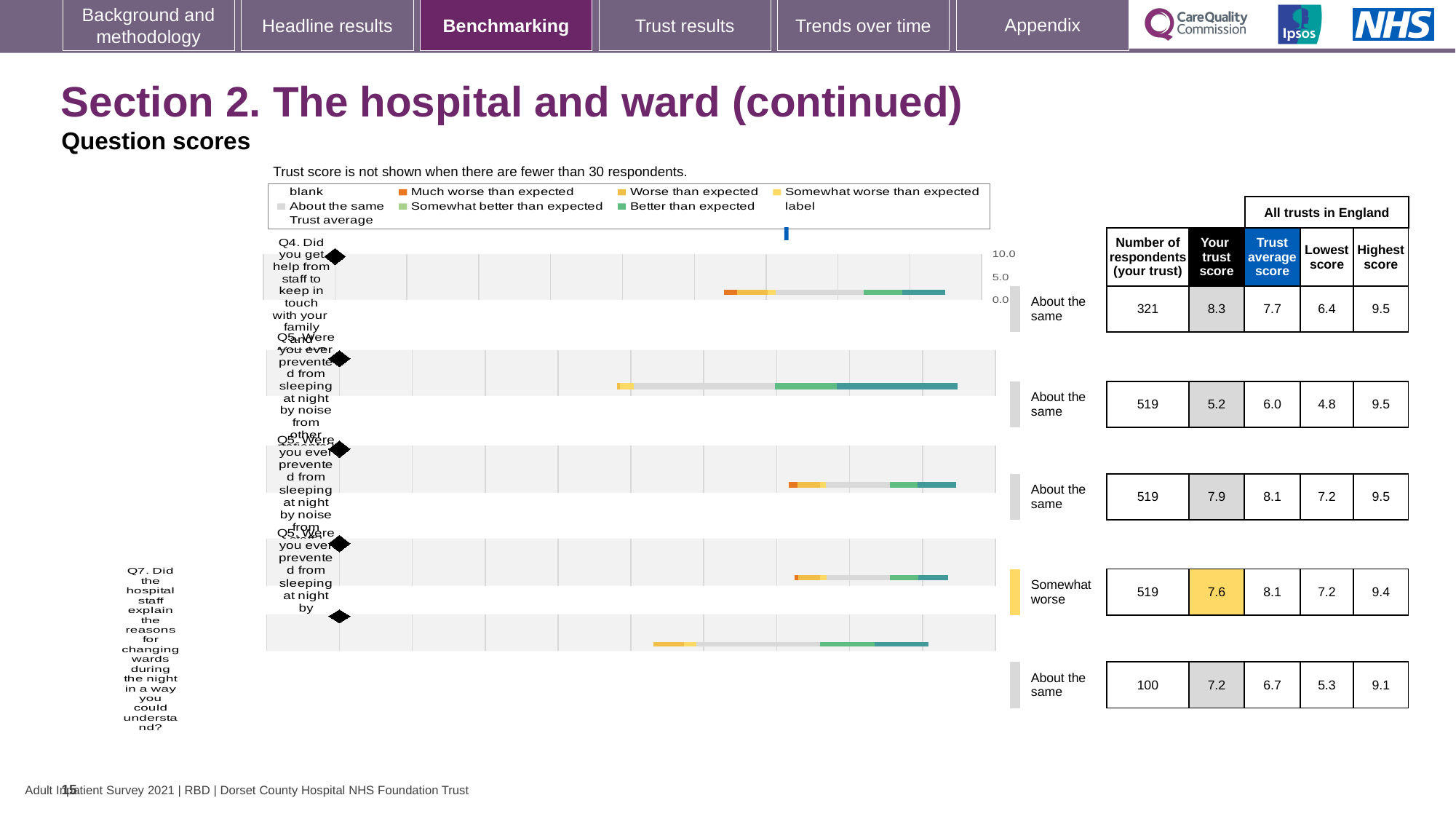
Which question row has the lowest trust score? the second row (5.2) How many respondents answered Q4 (help from staff to keep in touch with family)? 321 What is the difference between the trust score and the trust average score for Q4? 0.6 What is the highest score across all trusts in England for the second question row? 9.5 How many question rows (bars) are plotted in the chart? 5 What is the trust score for the second question row in the chart? 5.2 What is the trust average score for Q4 (help from staff to keep in touch with family)? 7.7 What is the trust score for Q4 (help from staff to keep in touch with family)? 8.3 Which question row is rated 'Somewhat worse' than expected? the fourth row (trust score 7.6) What is the trust score for Q7 (explaining reasons for changing wards during the night)? 7.2 What is the lowest score across all trusts in England for Q7 (explaining reasons for changing wards during the night)? 5.3 What kind of chart is shown on the slide? bar chart